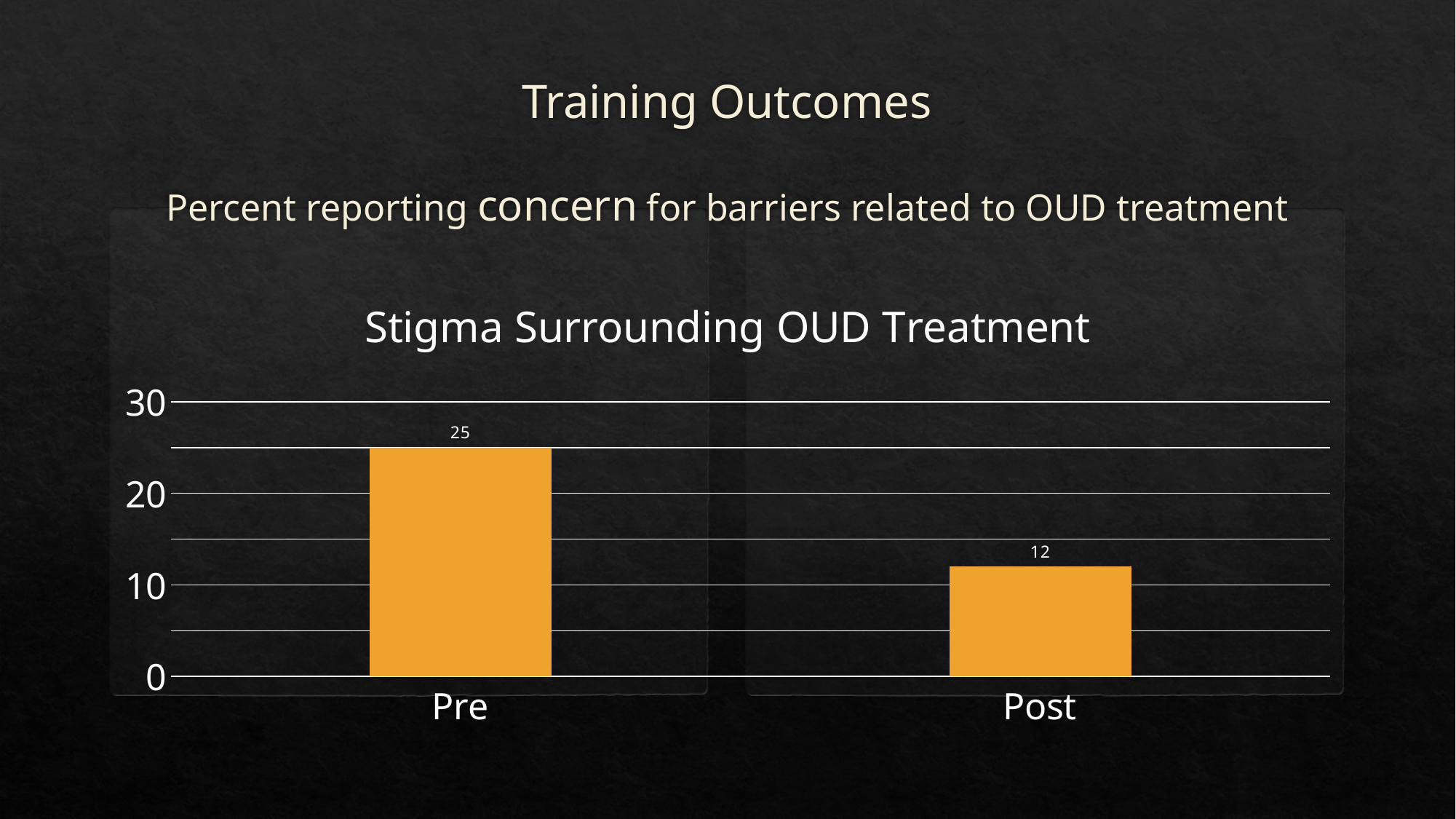
Is the value for Post greater or less than 20? less What is the title of the chart? Stigma Surrounding OUD Treatment What is the value for Pre? 25 Is the value for Pre greater or less than 20? greater Which category has the lowest value? Post What is the difference between the Pre and Post values? 13 Which is larger, the value for Pre or the value for Post? Pre What kind of chart is shown? bar chart Do the values rise or fall from Pre to Post? fall How many categories are shown on the x axis? 2 What is the value for Post? 12 Which category has the highest value? Pre